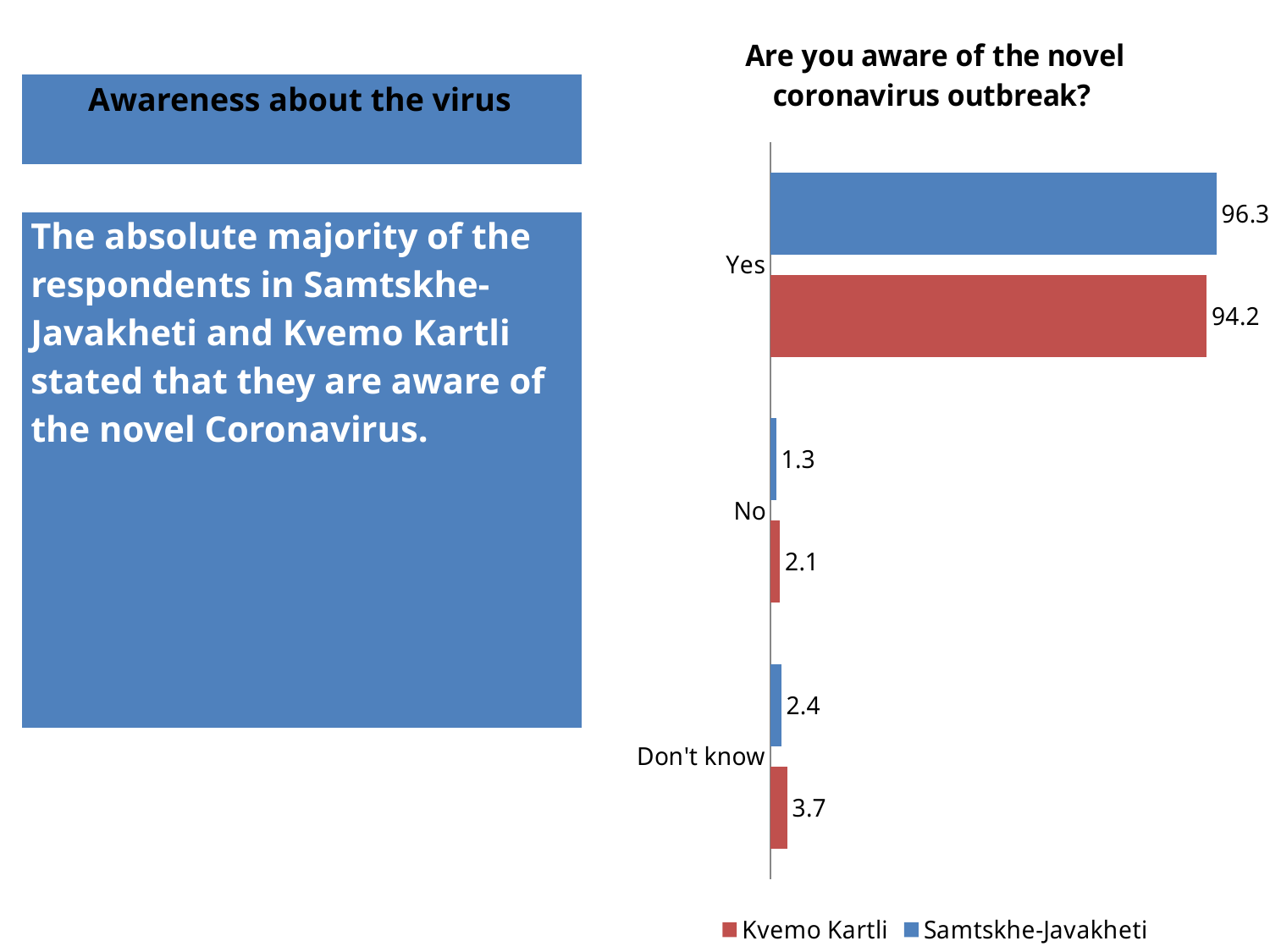
How many categories are shown on the chart? 3 What is the difference between the Samtskhe-Javakheti and Kvemo Kartli values in the Yes category? 2.1 What is the value for Kvemo Kartli in the Yes category? 94.2 In the Don't know category, which region has the larger value, Kvemo Kartli or Samtskhe-Javakheti? Kvemo Kartli What is the title of the chart? Are you aware of the novel coronavirus outbreak? What is the value for Samtskhe-Javakheti in the No category? 1.3 Which category has the lowest value for Samtskhe-Javakheti? No What is the value for Kvemo Kartli in the Don't know category? 3.7 Which category has the highest value for Kvemo Kartli? Yes What kind of chart is shown on the slide? Bar chart What is the value for Samtskhe-Javakheti in the Yes category? 96.3 How many series does the legend list? 2